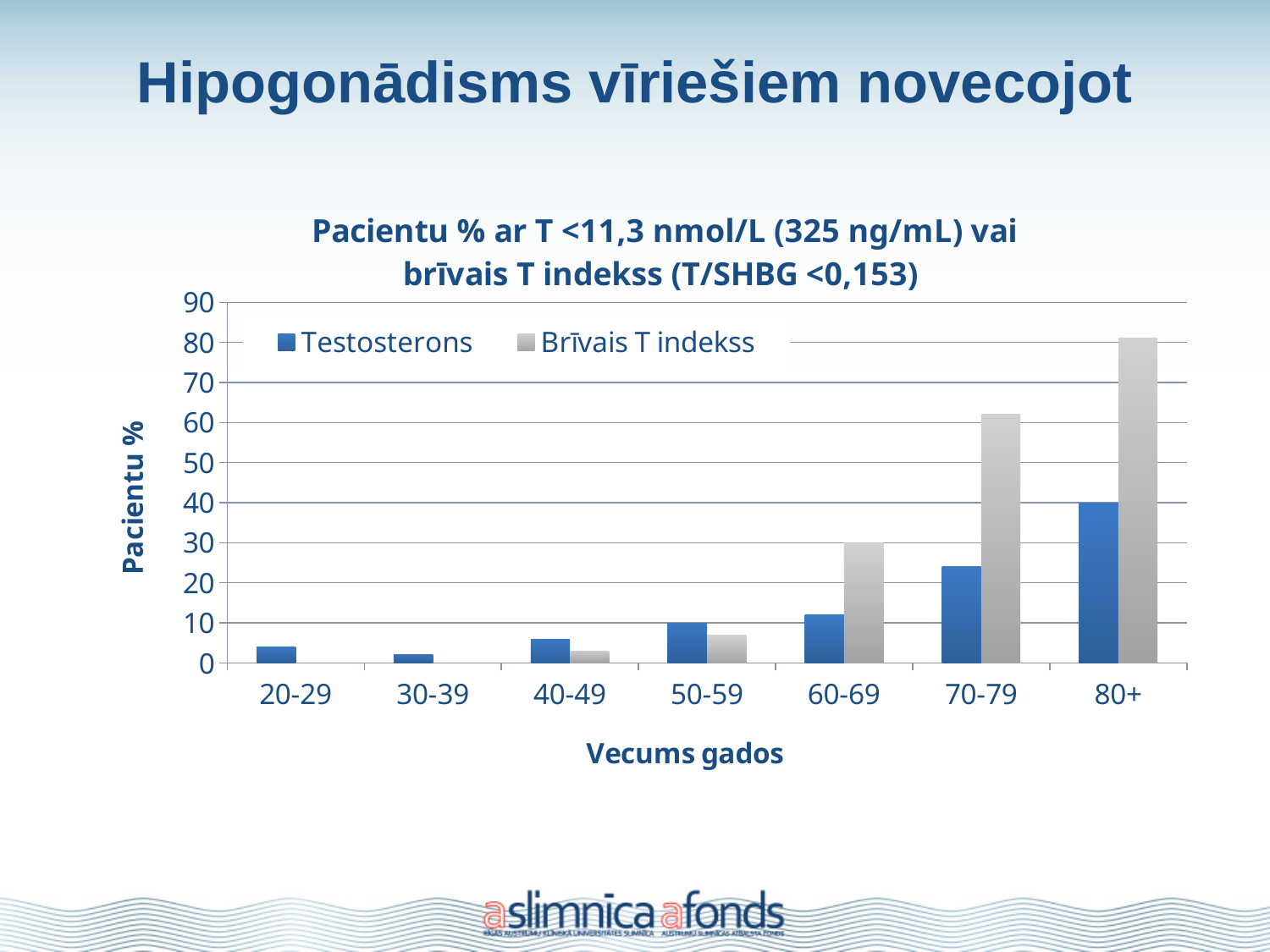
Which age group has the highest value for Testosterons? 80+ What kind of chart is shown on the slide? bar chart Do the Brīvais T indekss values generally rise or fall as age increases along the x axis? rise What is the label of the y axis? Pacientu % Which age group has the highest value for Brīvais T indekss? 80+ How many series does the legend list? 2 Which age group has the lowest value for Testosterons? 30-39 How many age groups are shown on the x axis? 7 Is the value for Testosterons in the 70-79 age group greater or less than 30? less Is the value for Brīvais T indekss in the 70-79 age group greater or less than 60? greater In the 80+ age group, which series has the larger value, Testosterons or Brīvais T indekss? Brīvais T indekss